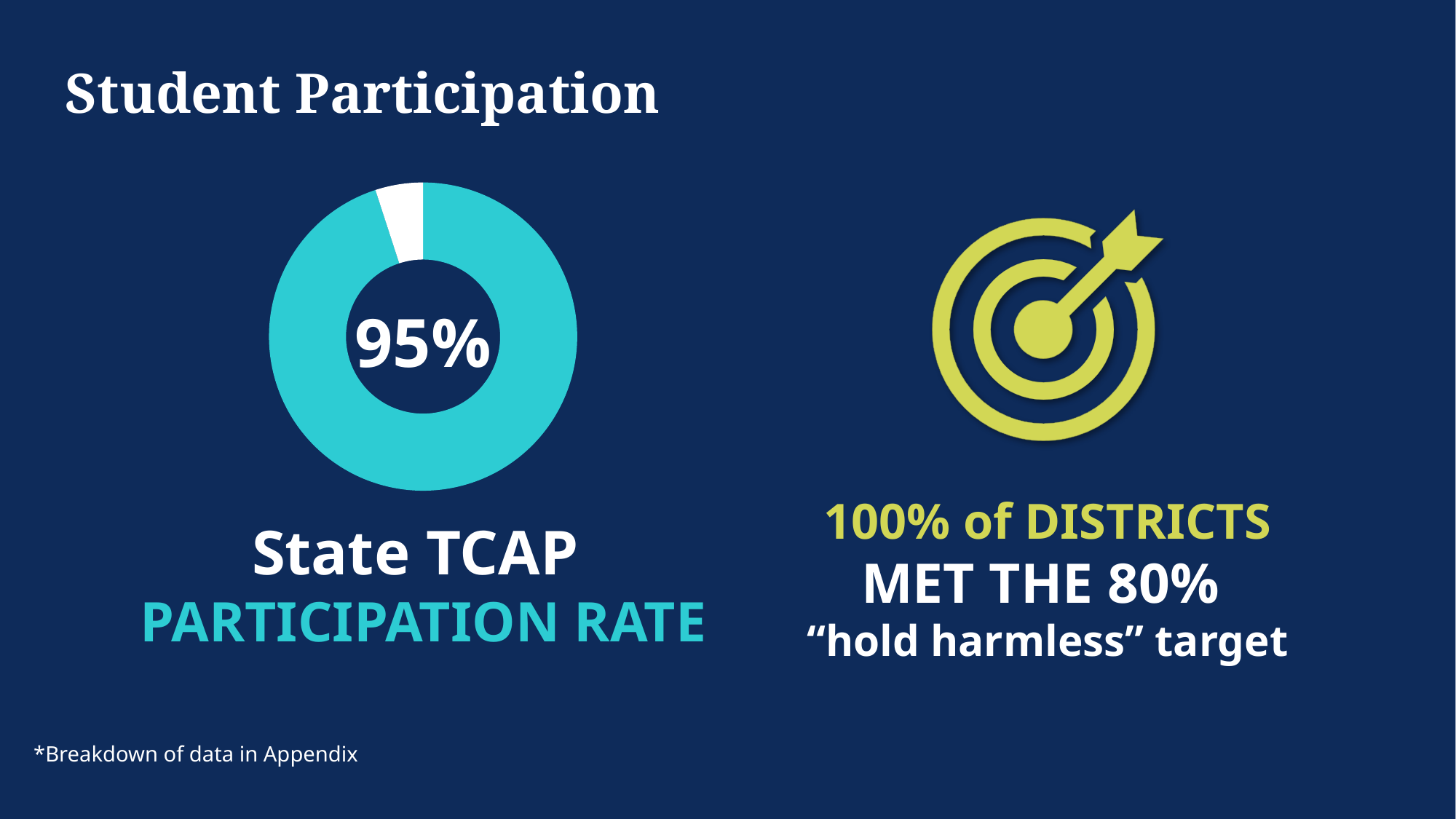
What percentage of districts met the 80% "hold harmless" target? 100% What share of the donut chart is left unfilled (white)? 5% What share of the donut chart is filled in teal? 95% Is the State TCAP participation rate greater or less than the 80% target mentioned on the slide? greater What kind of chart is used to show the State TCAP participation rate? Donut chart How many segments does the donut chart have? 2 What is the label under the donut chart? State TCAP PARTICIPATION RATE What is the State TCAP participation rate shown in the donut chart? 95% What colour is the filled portion of the donut chart? Teal